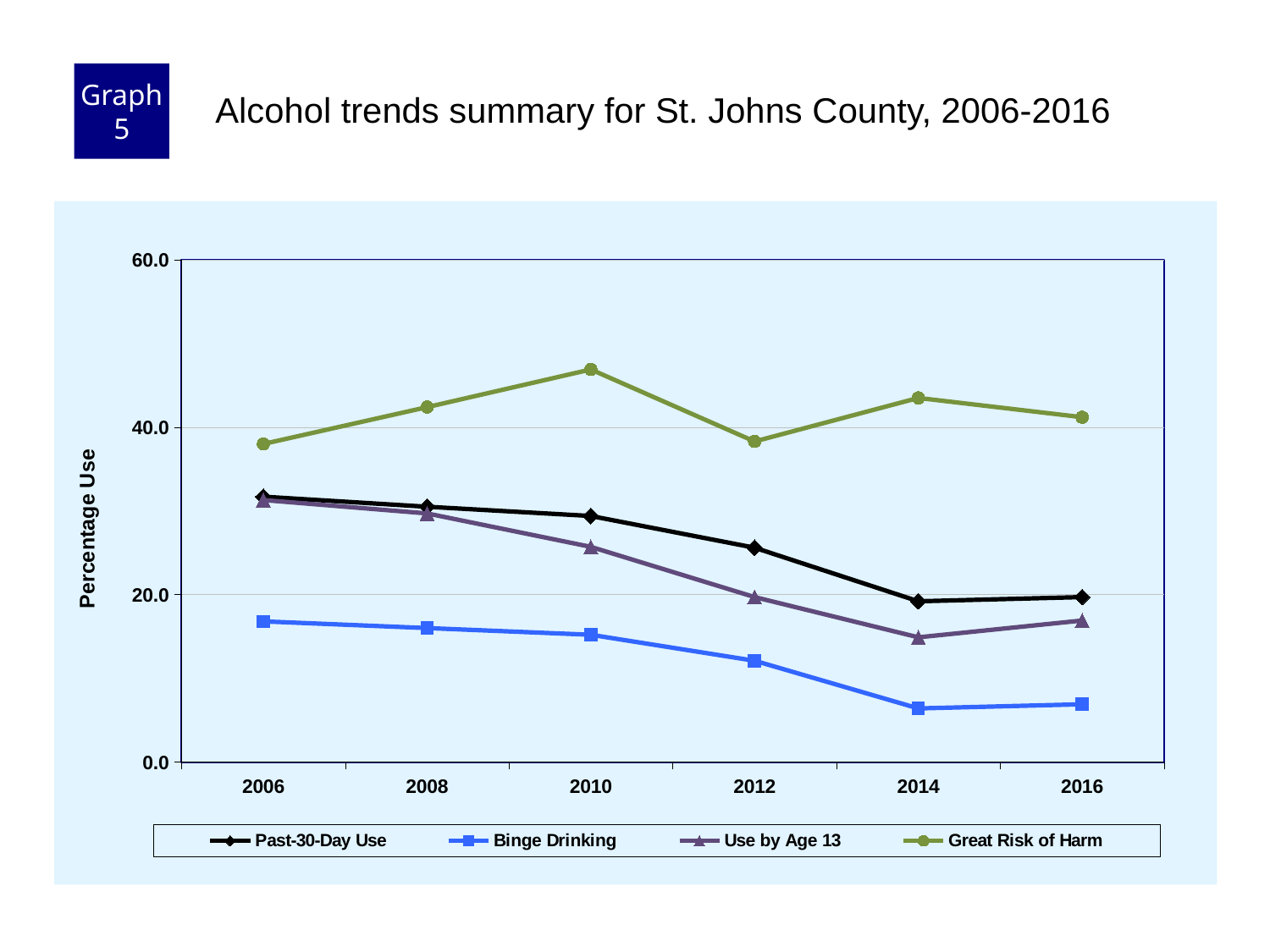
In which year does the Great Risk of Harm series reach its highest value? 2010 Which series has the highest value in 2016? Great Risk of Harm Is the value for Binge Drinking in 2014 greater or less than 20? less Is the value for Past-30-Day Use in 2006 greater or less than 20? greater Which series has the lowest value in 2016? Binge Drinking What kind of chart is shown on the slide? line chart How many years are plotted along the x axis? 6 Does the Binge Drinking series generally rise or fall from 2006 to 2016? fall Is the value for Great Risk of Harm in 2010 greater or less than 40? greater How many series does the legend list? 4 In 2012, which is larger: Past-30-Day Use or Use by Age 13? Past-30-Day Use What is the label on the y axis? Percentage Use